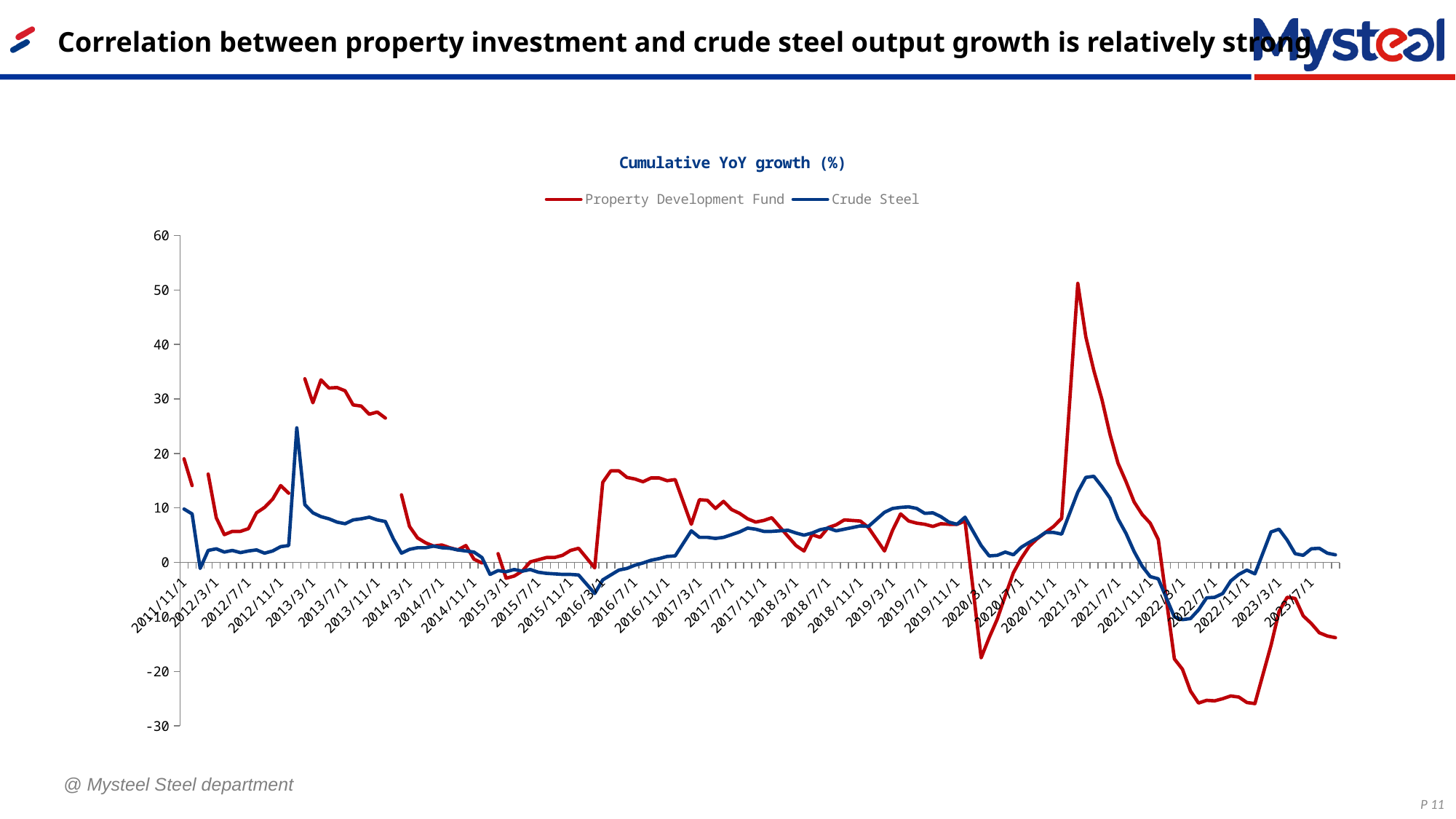
Is the value for Crude Steel at 2021/3/1 greater or less than 20? less Does the Property Development Fund line rise or fall between 2021/3/1 and 2022/7/1? fall Is the value for Property Development Fund at 2022/7/1 greater or less than -20? less Which colour is used for the Crude Steel line? blue Which series reaches the lowest value anywhere on the chart? Property Development Fund How many series does the legend list? 2 Is the value for Property Development Fund at 2021/3/1 greater or less than 40? greater At 2022/7/1, which series has the higher value, Property Development Fund or Crude Steel? Crude Steel What is the title of the chart? Cumulative YoY growth (%) Which series reaches the highest value anywhere on the chart? Property Development Fund What kind of chart is shown on the slide? line chart